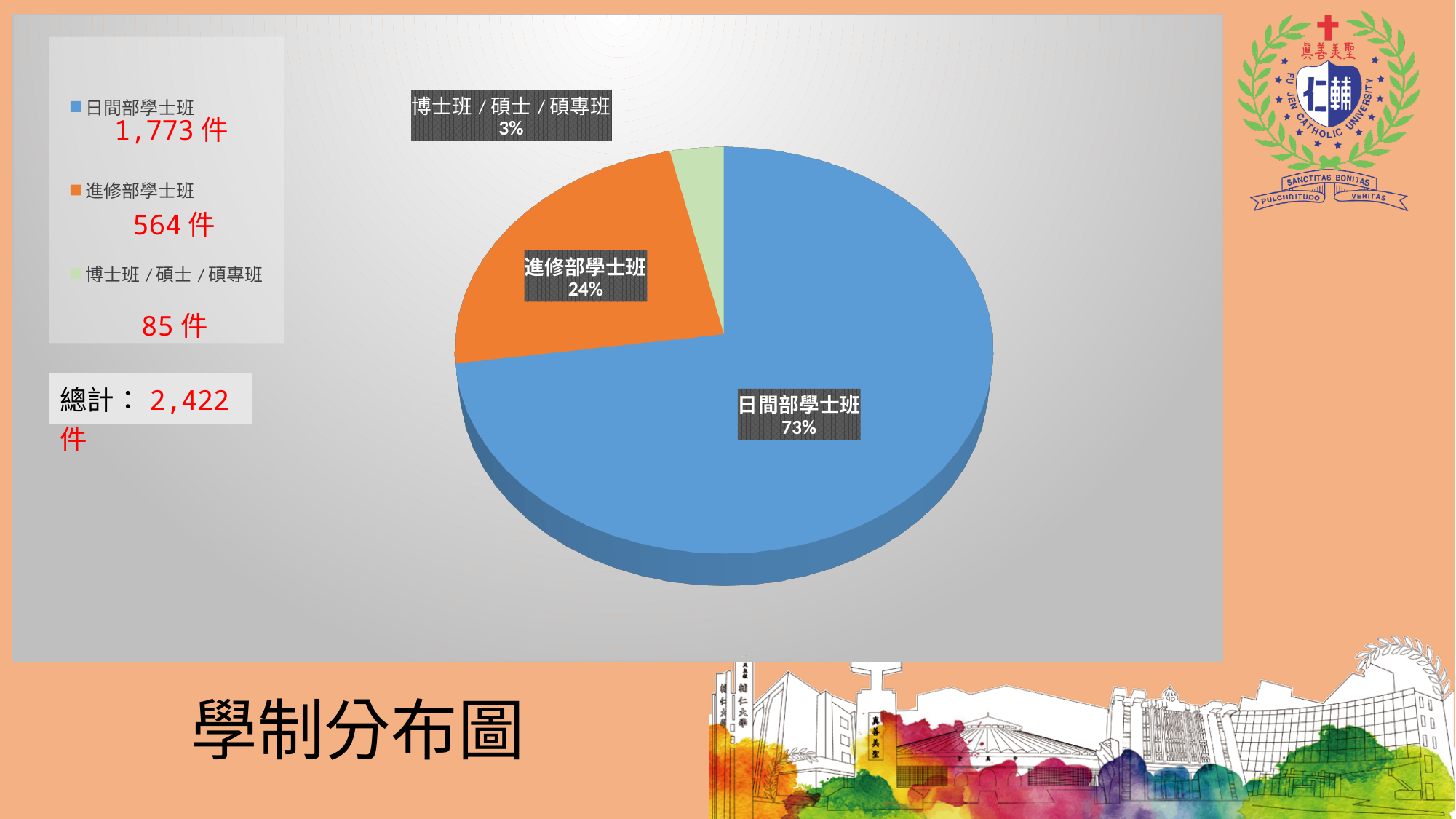
What is the difference in cases between 日間部學士班 and 進修部學士班? 1,209 件 What is the total (總計) number of cases shown on the slide? 2,422 件 Which category has the smallest slice of the pie chart? 博士班／碩士／碩專班 What percentage share does 博士班／碩士／碩專班 have in the pie chart? 3% How many cases (件) are listed for 日間部學士班? 1,773 件 How many cases (件) are listed for 博士班／碩士／碩專班? 85 件 What percentage share does 進修部學士班 have in the pie chart? 24% How many cases (件) are listed for 進修部學士班? 564 件 What percentage share does 日間部學士班 have in the pie chart? 73% What kind of chart is shown on the slide? pie chart Which category has the largest slice of the pie chart? 日間部學士班 How many categories does the pie chart have? 3